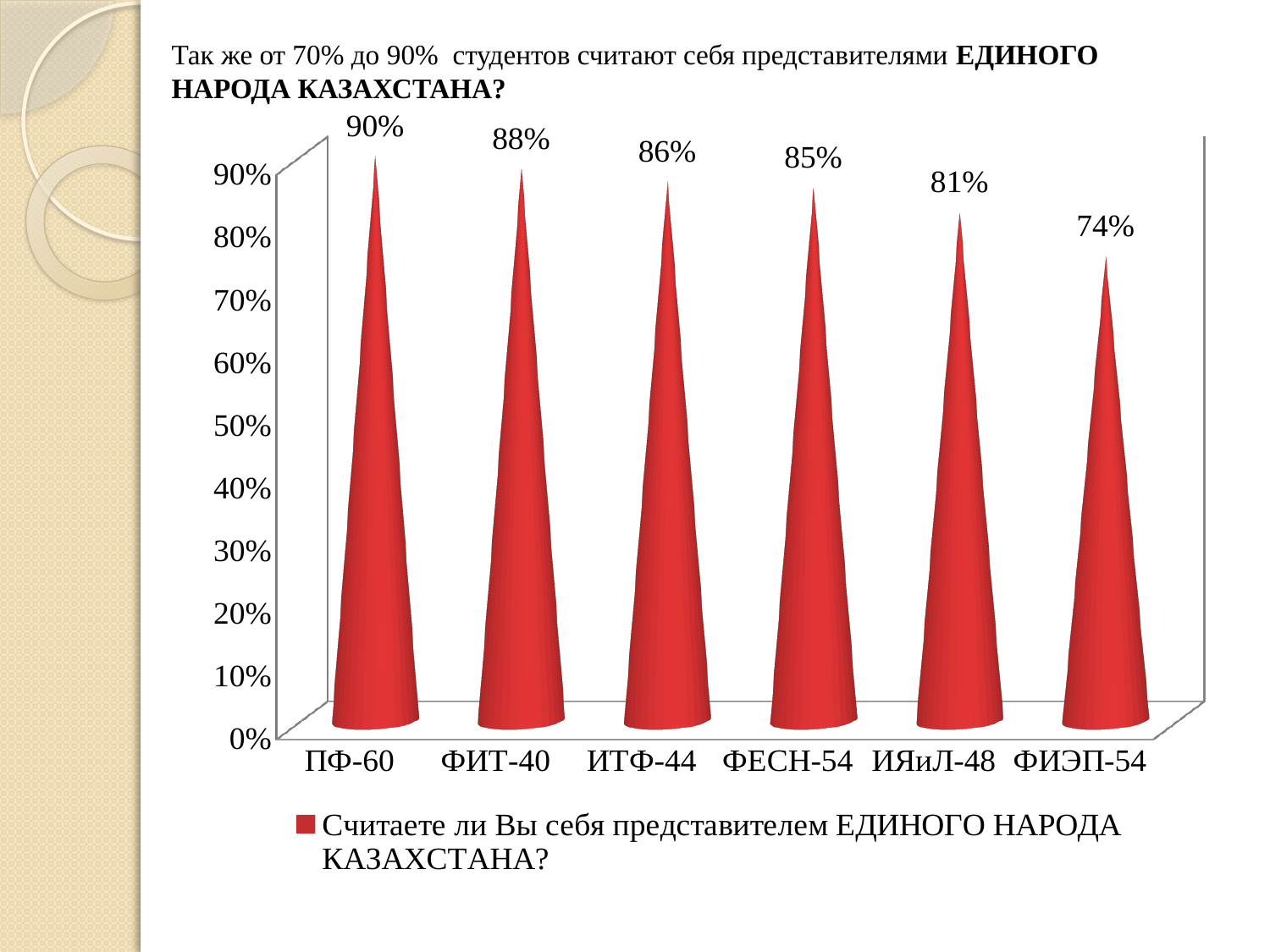
What is the difference between the values for ПФ-60 and ФИЭП-54? 16% What is the value for ИЯиЛ-48? 81% Which category has the highest value? ПФ-60 Which is larger, the value for ИЯиЛ-48 or the value for ФИЭП-54? ИЯиЛ-48 Do the values rise or fall from left to right along the x axis? fall What is the value for ПФ-60? 90% Which category has the lowest value? ФИЭП-54 What is the value for ФИЭП-54? 74% What is the value for ИТФ-44? 86% What is the value for ФИТ-40? 88% How many categories are shown on the x axis? 6 What is the value for ФЕСН-54? 85%